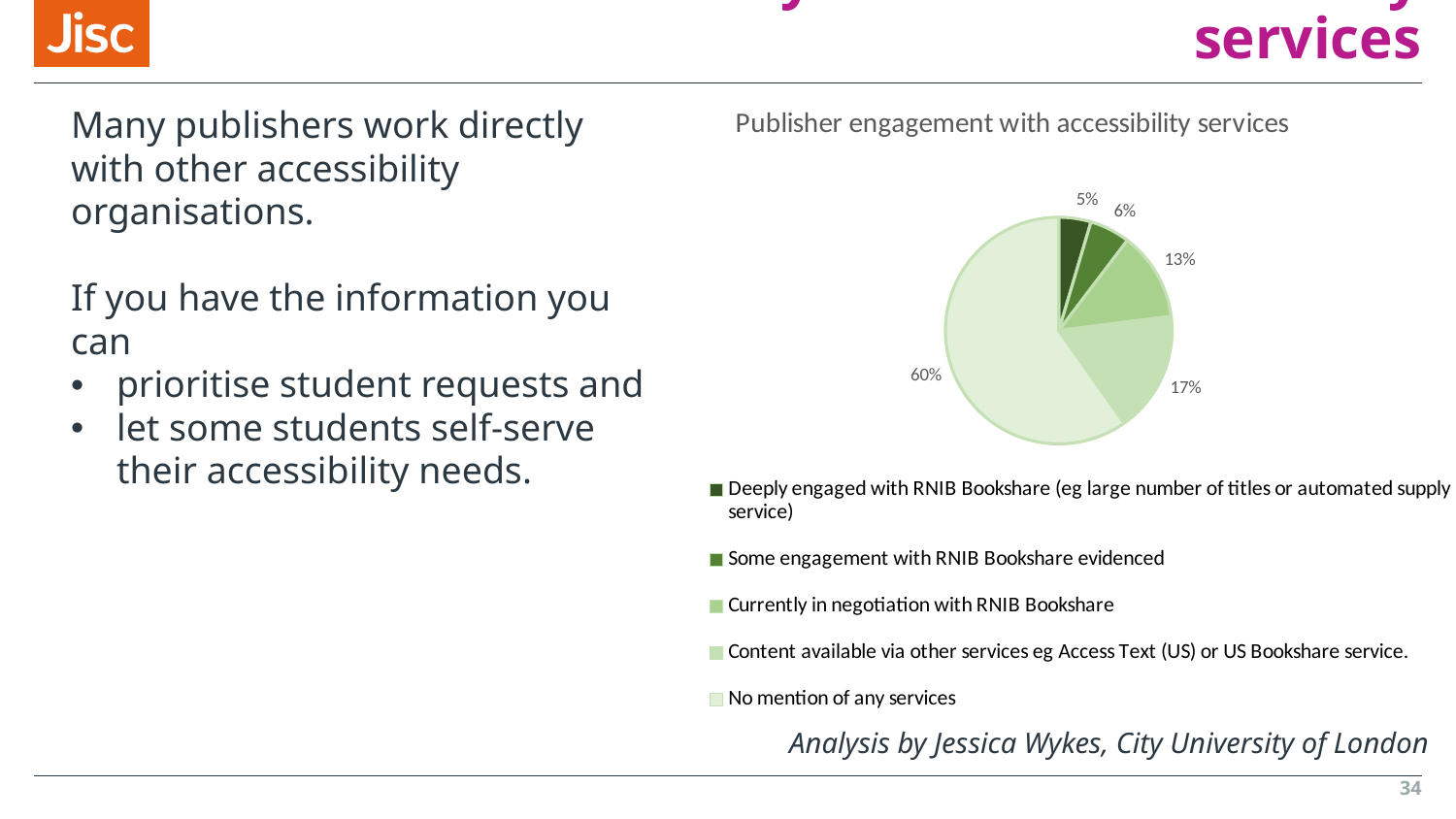
How many entries does the legend list? 5 What percentage is shown for 'Some engagement with RNIB Bookshare evidenced'? 6% What share of the pie is 'No mention of any services'? 60% What percentage is shown for 'Deeply engaged with RNIB Bookshare'? 5% What percentage is shown for 'Content available via other services eg Access Text (US) or US Bookshare service.'? 17% What kind of chart is shown on the slide? Pie chart What percentage is shown for 'Currently in negotiation with RNIB Bookshare'? 13% Which category has the largest slice of the pie? No mention of any services What is the title of the chart? Publisher engagement with accessibility services Which category has the smallest slice of the pie? Deeply engaged with RNIB Bookshare (eg large number of titles or automated supply service) What is the difference between the 'No mention of any services' slice and the 'Content available via other services' slice? 43% How many slices does the pie chart have? 5